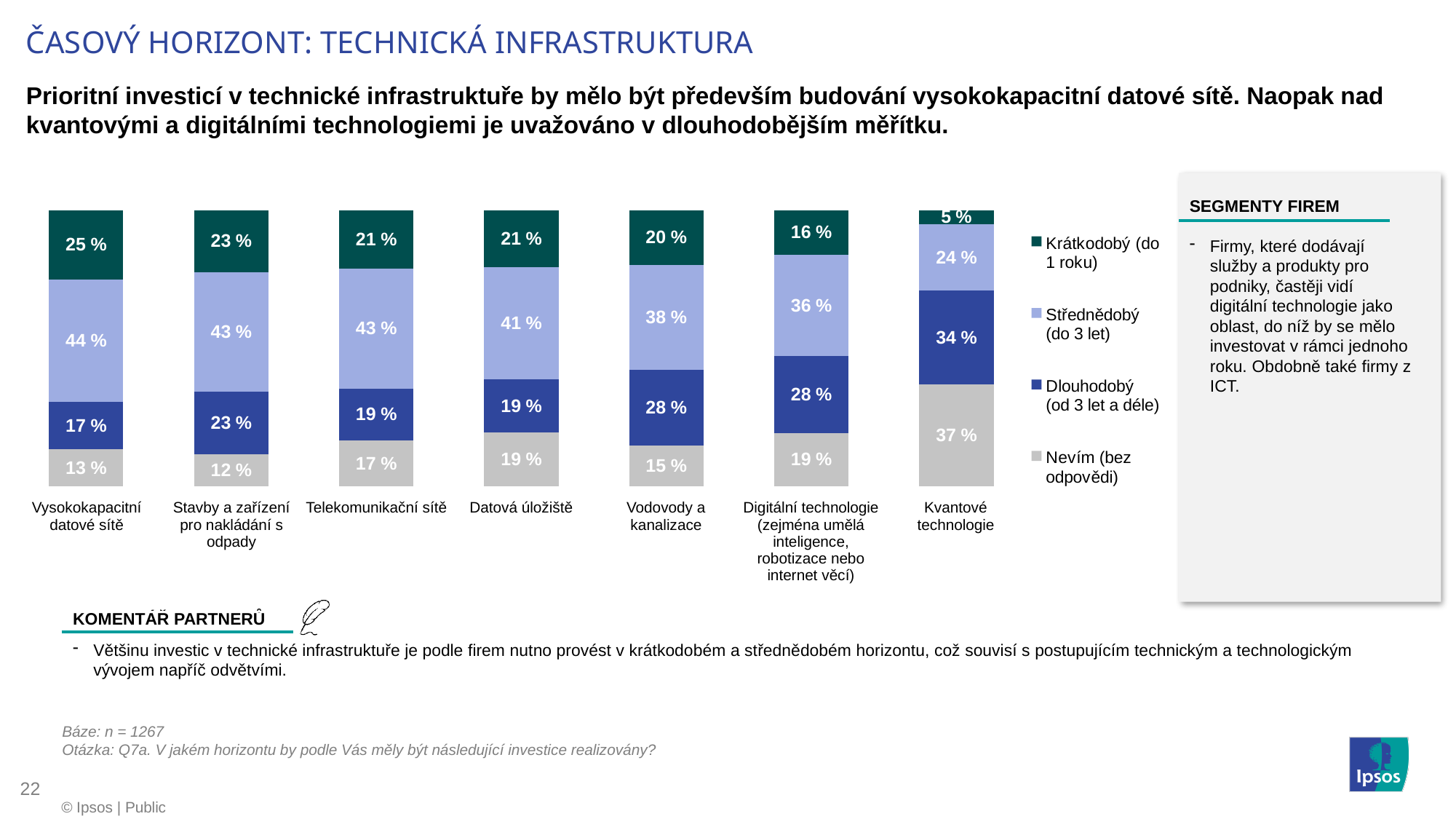
What is the value of the Dlouhodobý (od 3 let a déle) segment for Digitální technologie? 28 % Which category has the highest Krátkodobý (do 1 roku) value? Vysokokapacitní datové sítě Which category has the highest Dlouhodobý (od 3 let a déle) value? Kvantové technologie What is the value of the Krátkodobý (do 1 roku) segment for Vysokokapacitní datové sítě? 25 % How many categories are shown on the x axis of the chart? 7 Which has the larger Dlouhodobý (od 3 let a déle) value: Vodovody a kanalizace or Telekomunikační sítě? Vodovody a kanalizace Which category has the lowest Krátkodobý (do 1 roku) value? Kvantové technologie What kind of chart is shown on the slide? Stacked bar chart What is the difference between the Střednědobý (do 3 let) values for Vysokokapacitní datové sítě and Kvantové technologie? 20 % How many series does the legend list? 4 What is the total of the stacked bar for Telekomunikační sítě? 100 % What is the value of the Nevím (bez odpovědi) segment for Kvantové technologie? 37 %